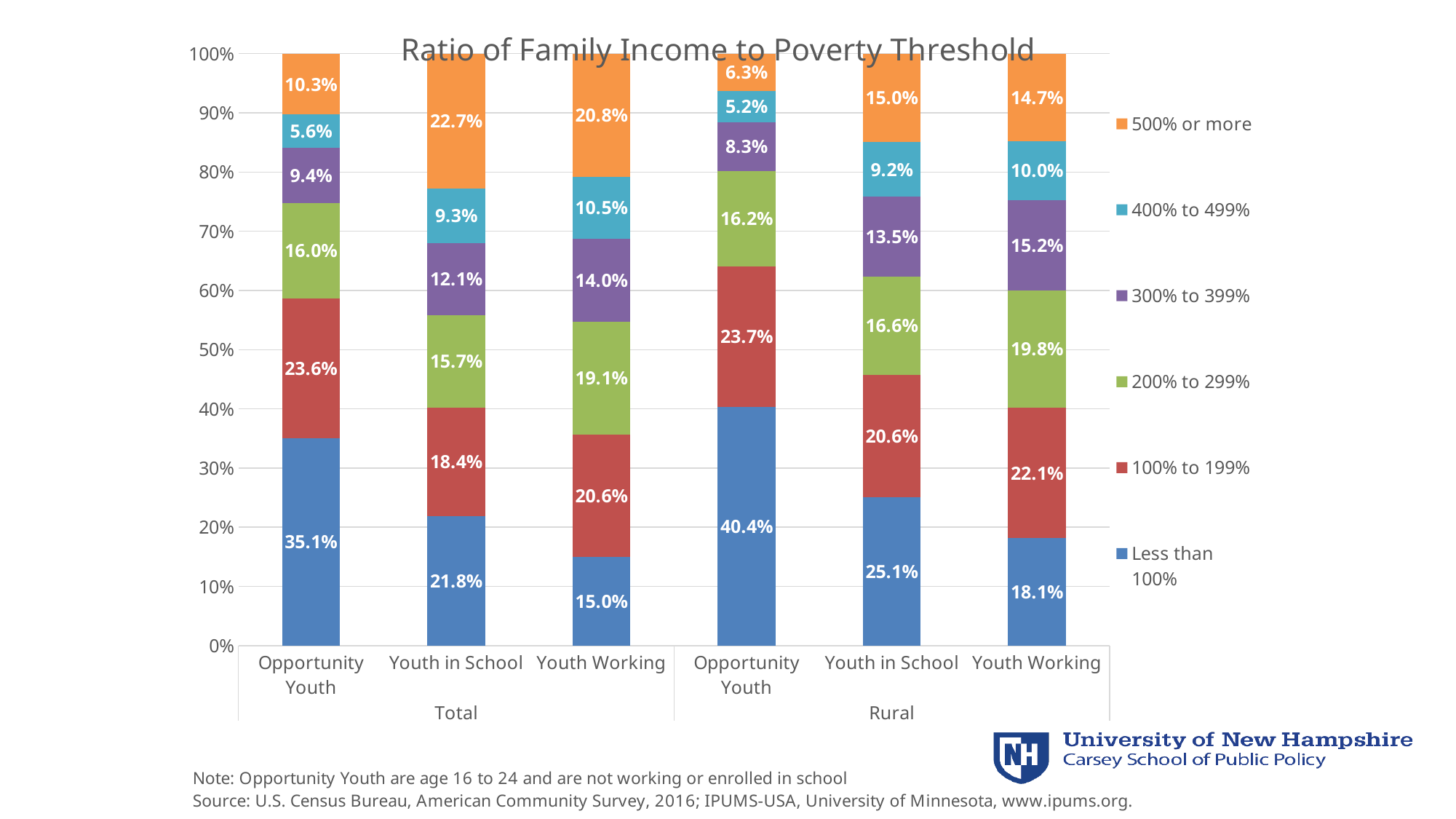
What percentage of Rural Opportunity Youth have a family income less than 100% of the poverty threshold? 40.4% Is the '100% to 199%' share larger for Youth in School in the Total group or in the Rural group? Rural Which bar has the smallest '500% or more' segment? Opportunity Youth (Rural) What is the value of the '500% or more' segment for Youth in School in the Total group? 22.7% How many percentage points higher is the 'Less than 100%' share for Opportunity Youth than for Youth Working in the Total group? 20.1 percentage points How many series does the legend list? 6 Which bar has the largest 'Less than 100%' segment? Opportunity Youth (Rural) What type of chart is shown? Stacked bar chart What is the title of the chart? Ratio of Family Income to Poverty Threshold What is the '300% to 399%' value for Youth Working in the Rural group? 15.2% Which legend entry is shown in orange? 500% or more How many bars are shown in the chart? 6